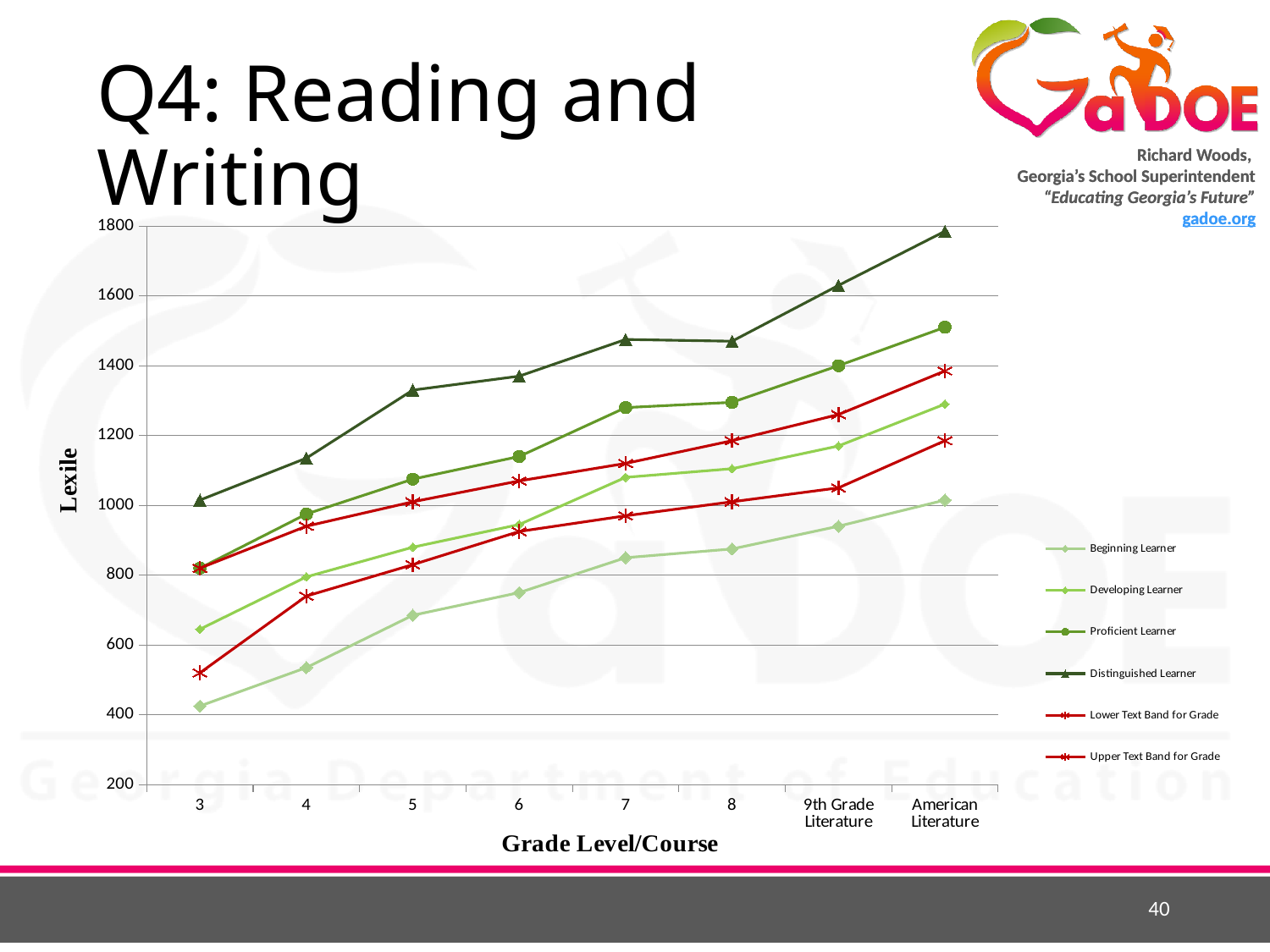
Which series has the lowest value at grade 3? Beginning Learner At grade 5, which is larger: Distinguished Learner or Proficient Learner? Distinguished Learner Is the value for Distinguished Learner at American Literature greater or less than 1600? greater Which series has the highest value at American Literature? Distinguished Learner What is the title of the vertical axis? Lexile How many series does the legend list? 6 How many grade level/course categories are plotted along the x axis? 8 What is the title of the horizontal axis? Grade Level/Course Do the Distinguished Learner values rise or fall from grade 3 to American Literature? rise Is the value for Beginning Learner at grade 3 greater or less than 600? less Is the value for Proficient Learner at grade 8 greater or less than 1200? greater What kind of chart is shown on the slide? line chart